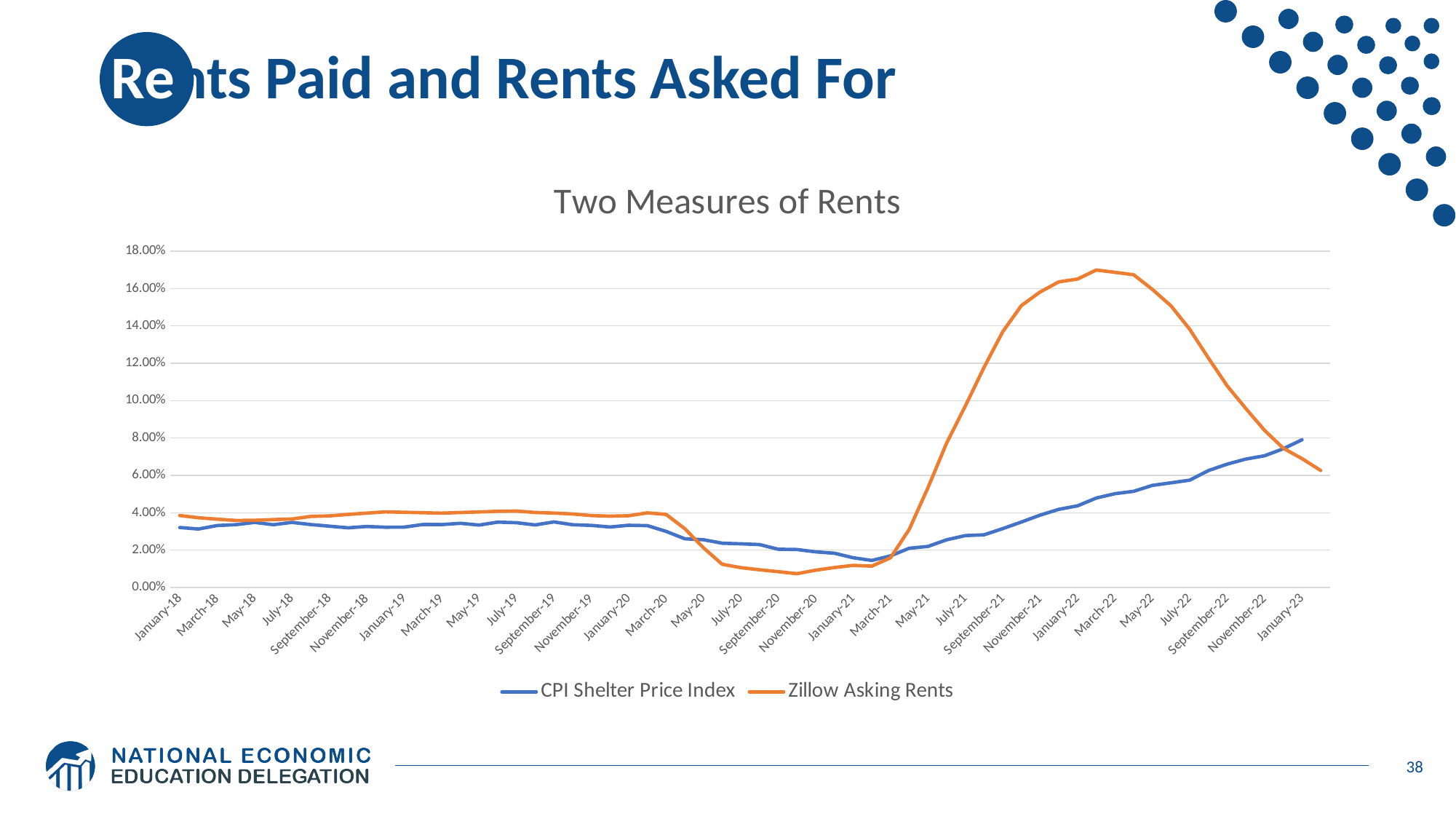
Is the value for CPI Shelter Price Index at January-18 greater or less than 4.00%? less At July-20, which series has the higher value, CPI Shelter Price Index or Zillow Asking Rents? CPI Shelter Price Index Is the value for Zillow Asking Rents at September-20 greater or less than 2.00%? less What is the title of the chart? Two Measures of Rents Does the Zillow Asking Rents line rise or fall between March-22 and January-23? Fall Which series reaches the highest value on the chart? Zillow Asking Rents Is the value for Zillow Asking Rents at March-22 greater or less than 16.00%? greater Which series is drawn in orange? Zillow Asking Rents What kind of chart is shown on the slide? Line chart How many series does the legend list? 2 At January-23, which series has the higher value, CPI Shelter Price Index or Zillow Asking Rents? CPI Shelter Price Index